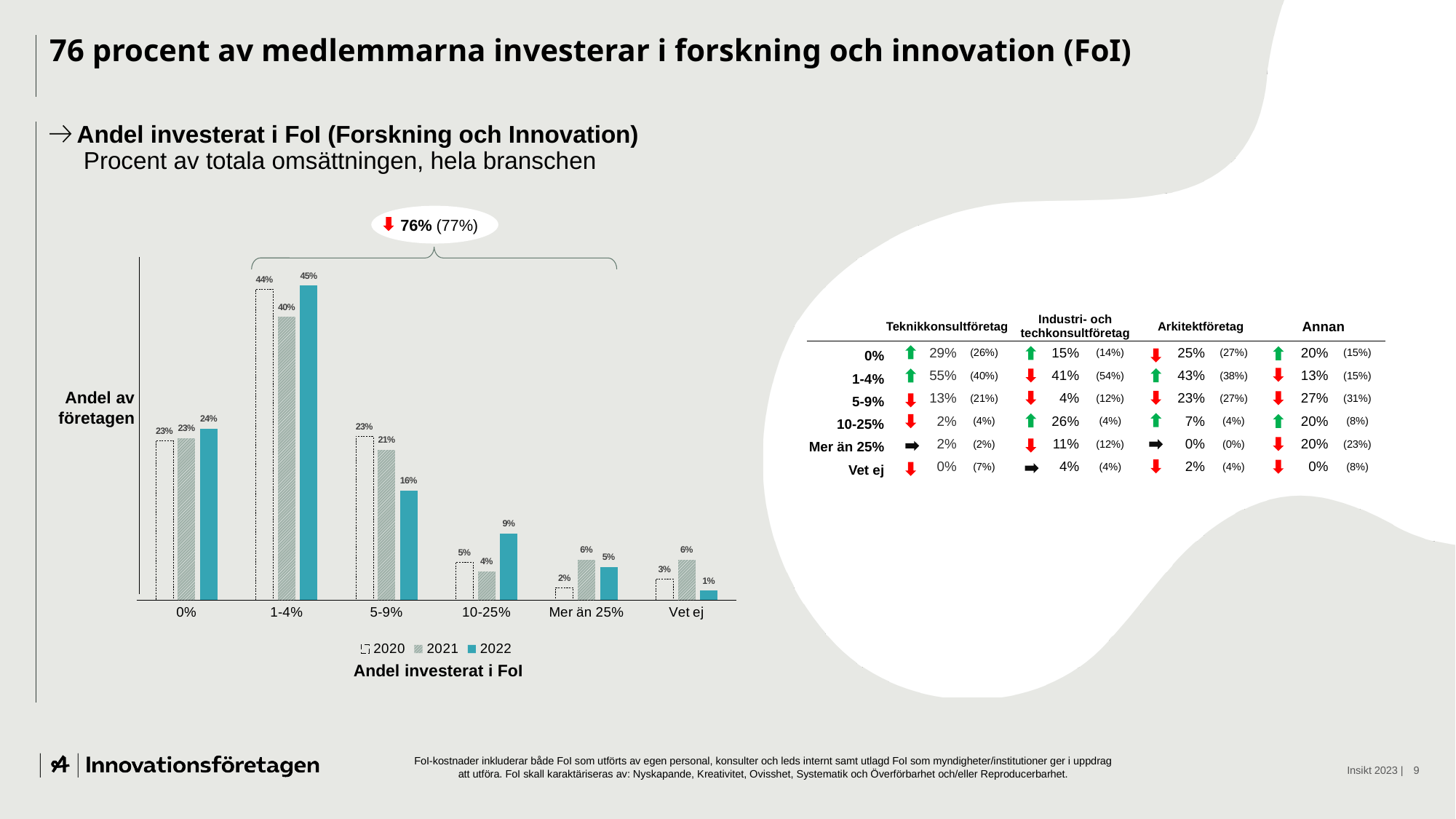
What is the value for 2022 in the 1-4% category? 45% Which is larger in the Vet ej category: the 2021 value or the 2022 value? 2021 What is the difference between the 2022 and 2021 values in the 5-9% category? 5% What kind of chart is shown on the slide? bar chart Which category has the lowest value for the 2022 series? Vet ej What is the difference between the 2022 and 2020 values in the 10-25% category? 4% What is the value for 2021 in the 5-9% category? 21% How many categories are shown on the x axis of the chart? 6 How many series does the chart legend list? 3 What label is shown below the legend of the chart? Andel investerat i FoI What is the value for 2020 in the 10-25% category? 5% Which category has the highest value for the 2022 series? 1-4%